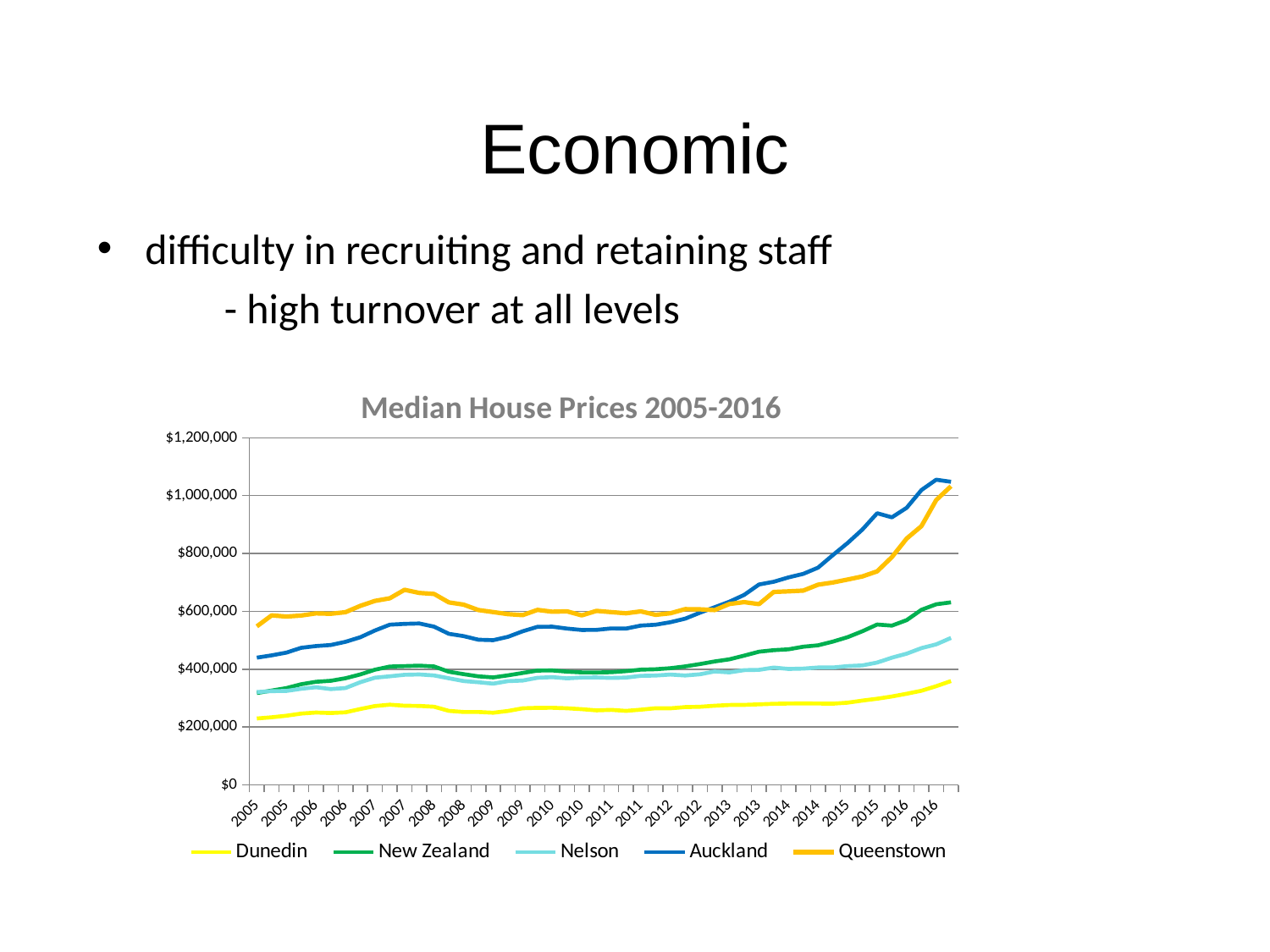
Is the Auckland median house price at the end of 2016 greater or less than $1,000,000? greater In 2005, which is larger: the median house price for Auckland or for Queenstown? Queenstown At the end of 2016, which is larger: the median house price for Nelson or for New Zealand? New Zealand Which series has the highest median house price at the start of 2005? Queenstown Is the Nelson median house price at the end of 2016 greater or less than $400,000? greater Which series has the lowest median house price across the whole period? Dunedin What is the title of the chart on the slide? Median House Prices 2005-2016 Is the Dunedin median house price in 2005 greater or less than $400,000? less How many series does the legend of the Median House Prices chart list? 5 Does the Auckland median house price rise or fall overall from 2005 to 2016? rise What colour is the Auckland line in the chart? blue What kind of chart is shown on the slide? line chart